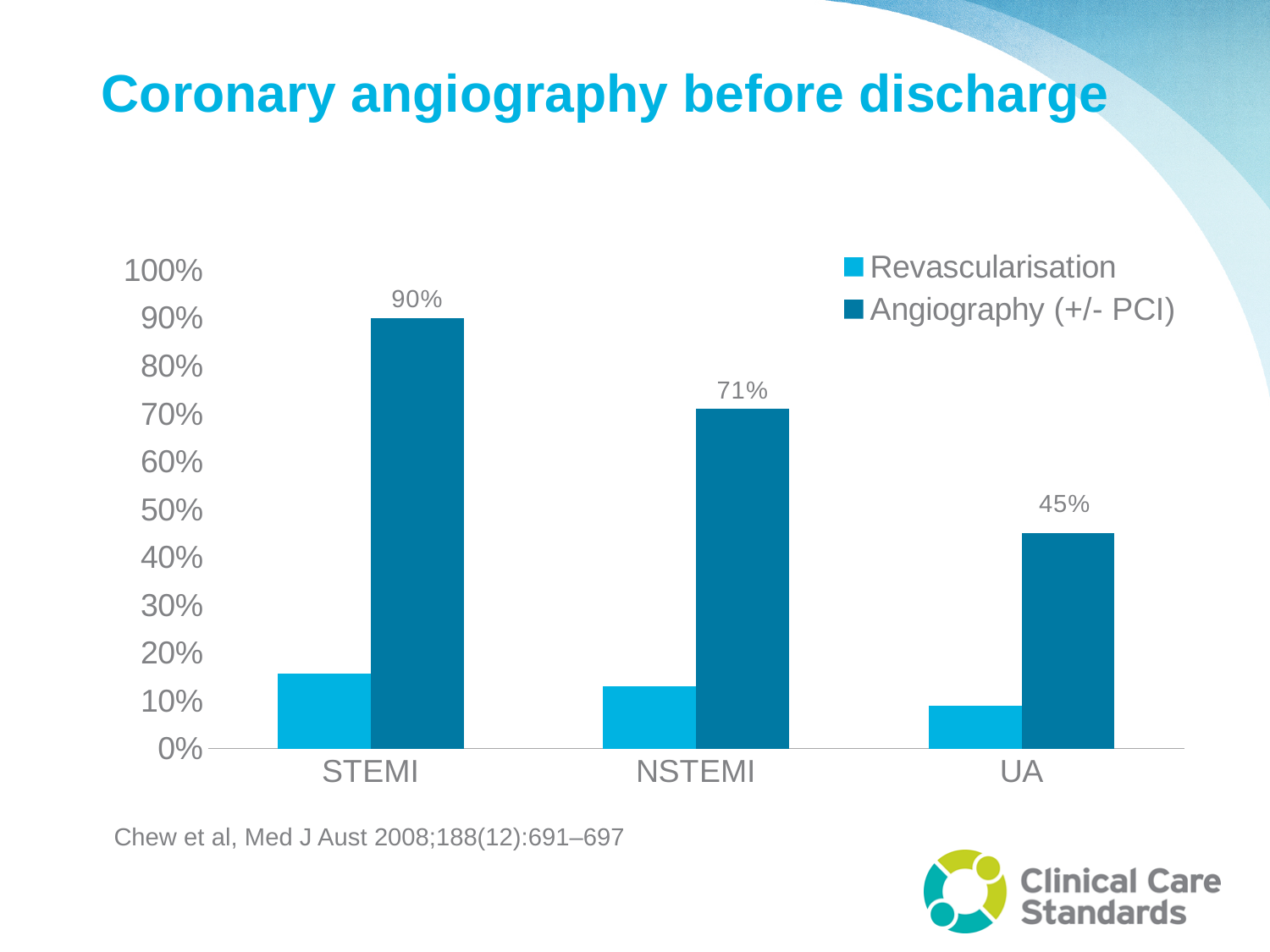
Is the Revascularisation value for STEMI greater or less than 20%? less What is the difference between the Angiography (+/- PCI) values for STEMI and UA? 45% Is the Revascularisation value for NSTEMI greater or less than 10%? greater Which category has the highest Angiography (+/- PCI) value? STEMI How many categories are shown on the x axis? 3 Which is larger: the Revascularisation value for STEMI or the Revascularisation value for UA? STEMI What is the difference between the Angiography (+/- PCI) values for STEMI and NSTEMI? 19% What is the Angiography (+/- PCI) value for NSTEMI? 71% What is the Angiography (+/- PCI) value for STEMI? 90% How many series does the legend list? 2 Which category has the lowest Angiography (+/- PCI) value? UA What is the Angiography (+/- PCI) value for UA? 45%